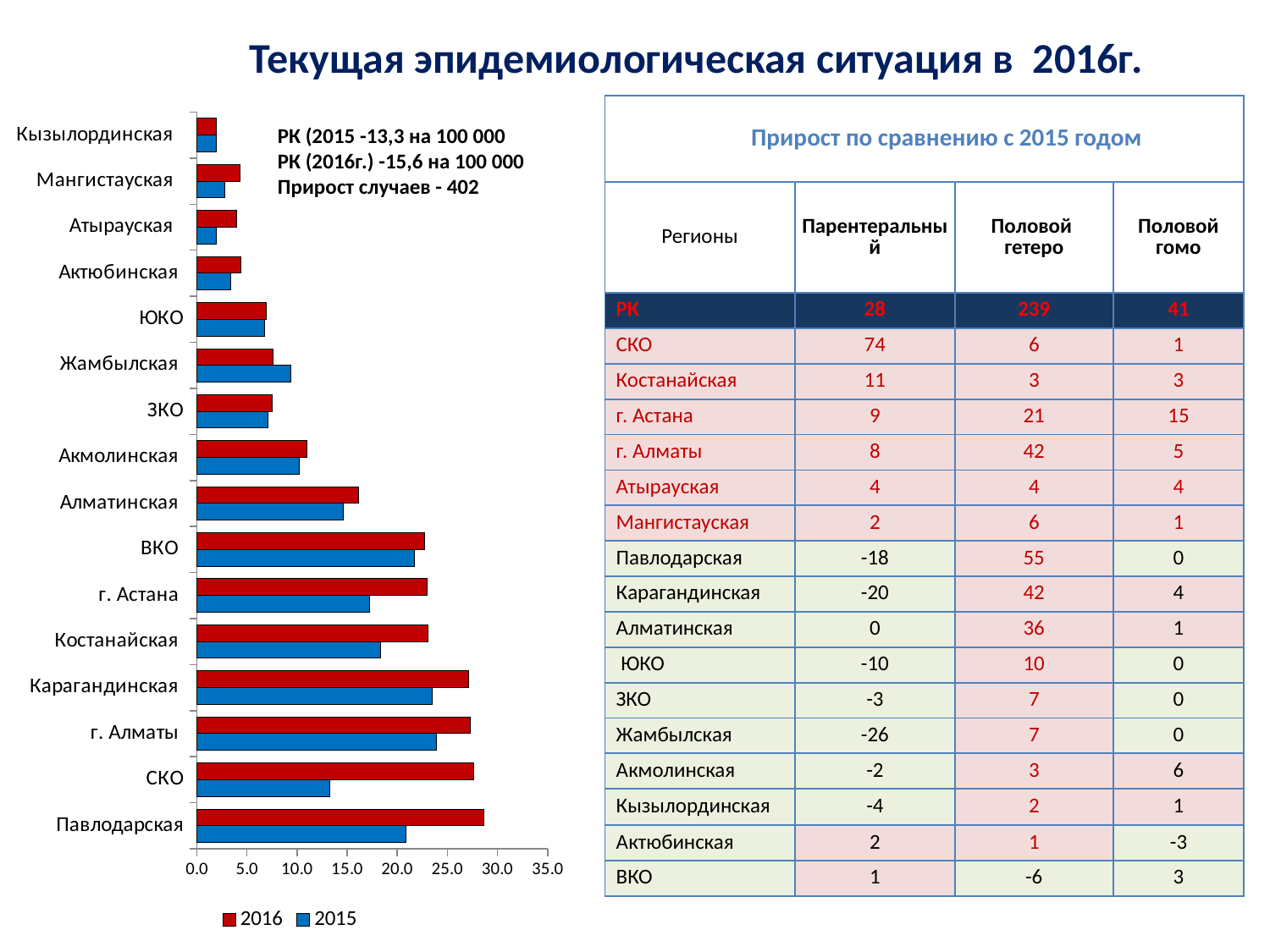
Which colour represents the 2016 series on the bar chart? red Which region has the lowest 2016 value on the bar chart? Кызылординская On the bar chart, which is larger for Жамбылская: the 2016 value or the 2015 value? 2015 On the bar chart, is the 2016 value for Павлодарская greater or less than 25.0? greater How many series does the legend of the bar chart list? 2 On the bar chart, is the 2016 value for ВКО greater or less than 20.0? greater On the bar chart, is the 2015 value for СКО greater or less than 15.0? less What kind of chart is shown on the left of the slide? bar chart Which region has the highest 2016 value on the bar chart? Павлодарская On the bar chart, which is larger for СКО: the 2016 value or the 2015 value? 2016 How many regions are plotted on the bar chart? 16